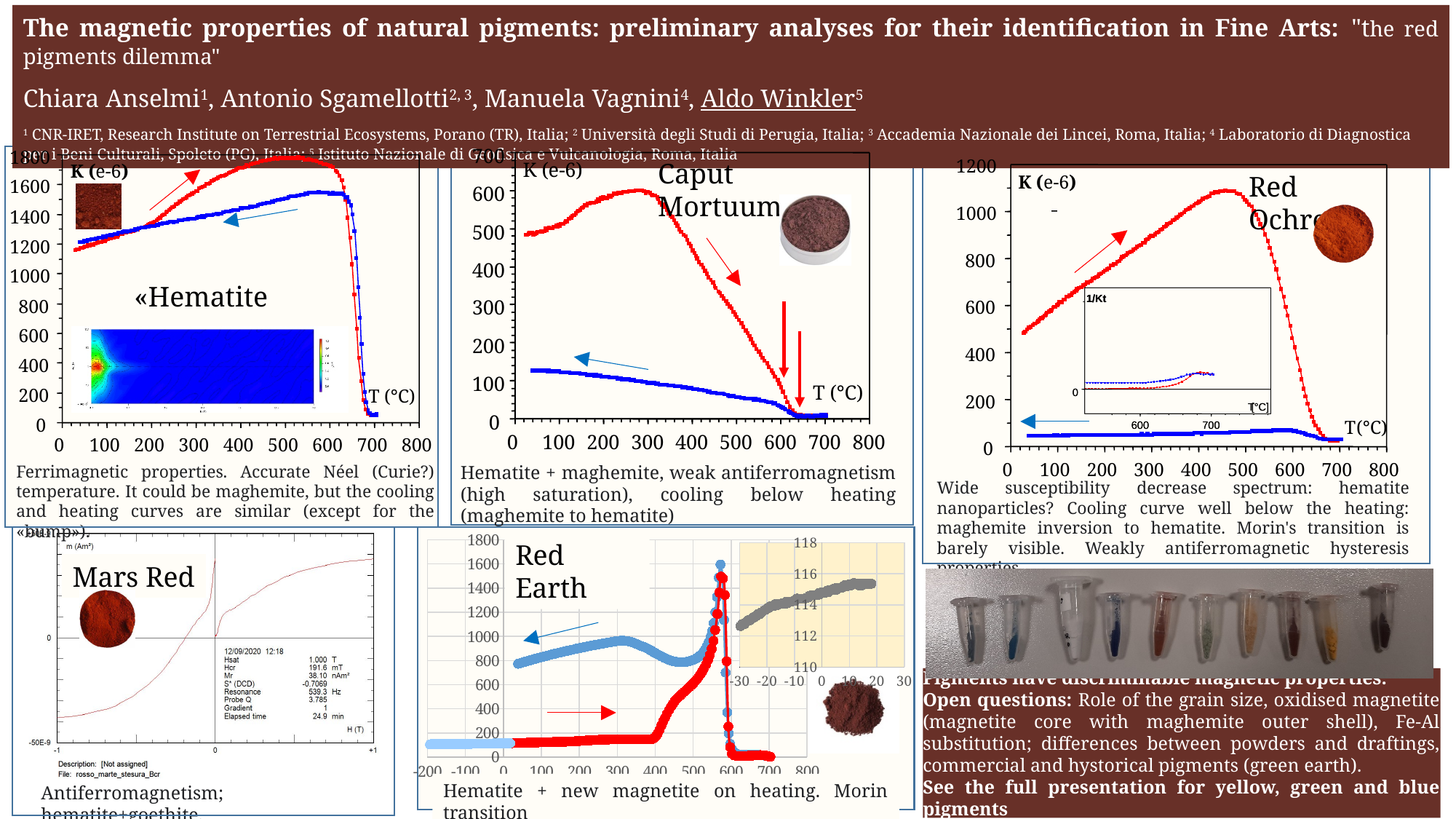
In the Caput Mortuum chart (top middle), which curve has the larger value at 100 °C, the red one or the blue one? the red one In the Hematite chart (top left), is the value of the red heating curve at 500 °C greater or less than 1600? greater In the Red Earth chart (bottom middle), is the value of the light blue curve at 0 °C greater or less than 1000? less In the Caput Mortuum chart (top middle), is the value of the red curve at 300 °C greater or less than 500? greater In the Hematite chart (top left), do the curves rise or fall between 600 °C and 700 °C? fall In the Red Ochre chart (top right), does the red curve rise or fall between 100 °C and 400 °C? rise In the Mars Red chart (bottom left), what Hcr value is listed in the data box? 191.6 mT What is the maximum value shown on the vertical axis of the Hematite chart (top left)? 1800